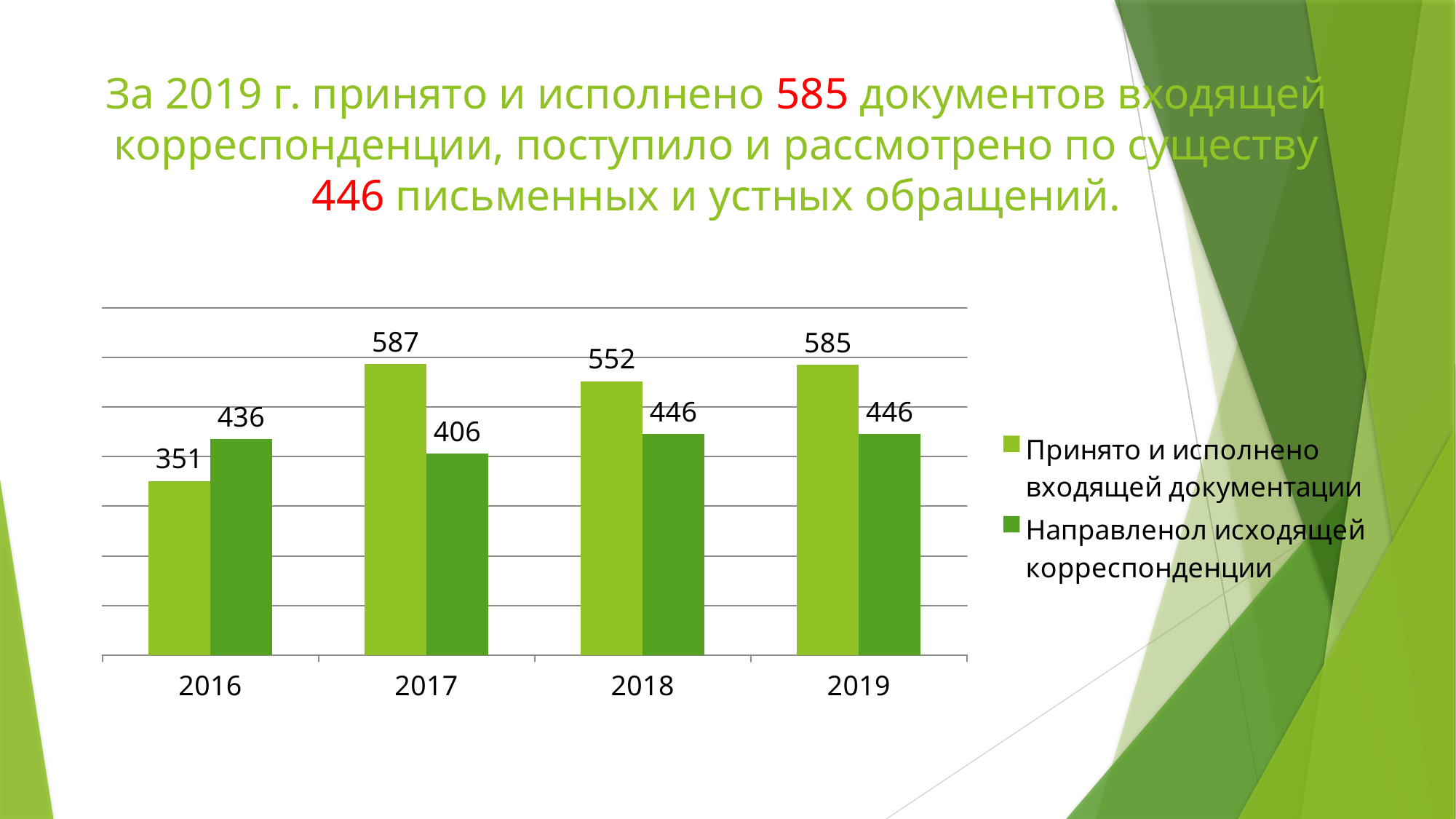
How many years are shown on the x axis of the chart? 4 In which year is the value for 'Принято и исполнено входящей документации' the lowest? 2016 In 2016, which series has the larger value? Направленол исходящей корреспонденции In which year is the value for 'Направленол исходящей корреспонденции' the lowest? 2017 What is the difference between the two series' values in 2019? 139 What is the value for 'Принято и исполнено входящей документации' in 2019? 585 What is the value for 'Принято и исполнено входящей документации' in 2016? 351 In which year is the value for 'Принято и исполнено входящей документации' the highest? 2017 How many series does the chart's legend list? 2 What is the value for 'Направленол исходящей корреспонденции' in 2017? 406 What is the value for 'Направленол исходящей корреспонденции' in 2016? 436 What is the difference between the 'Принято и исполнено входящей документации' values for 2017 and 2018? 35